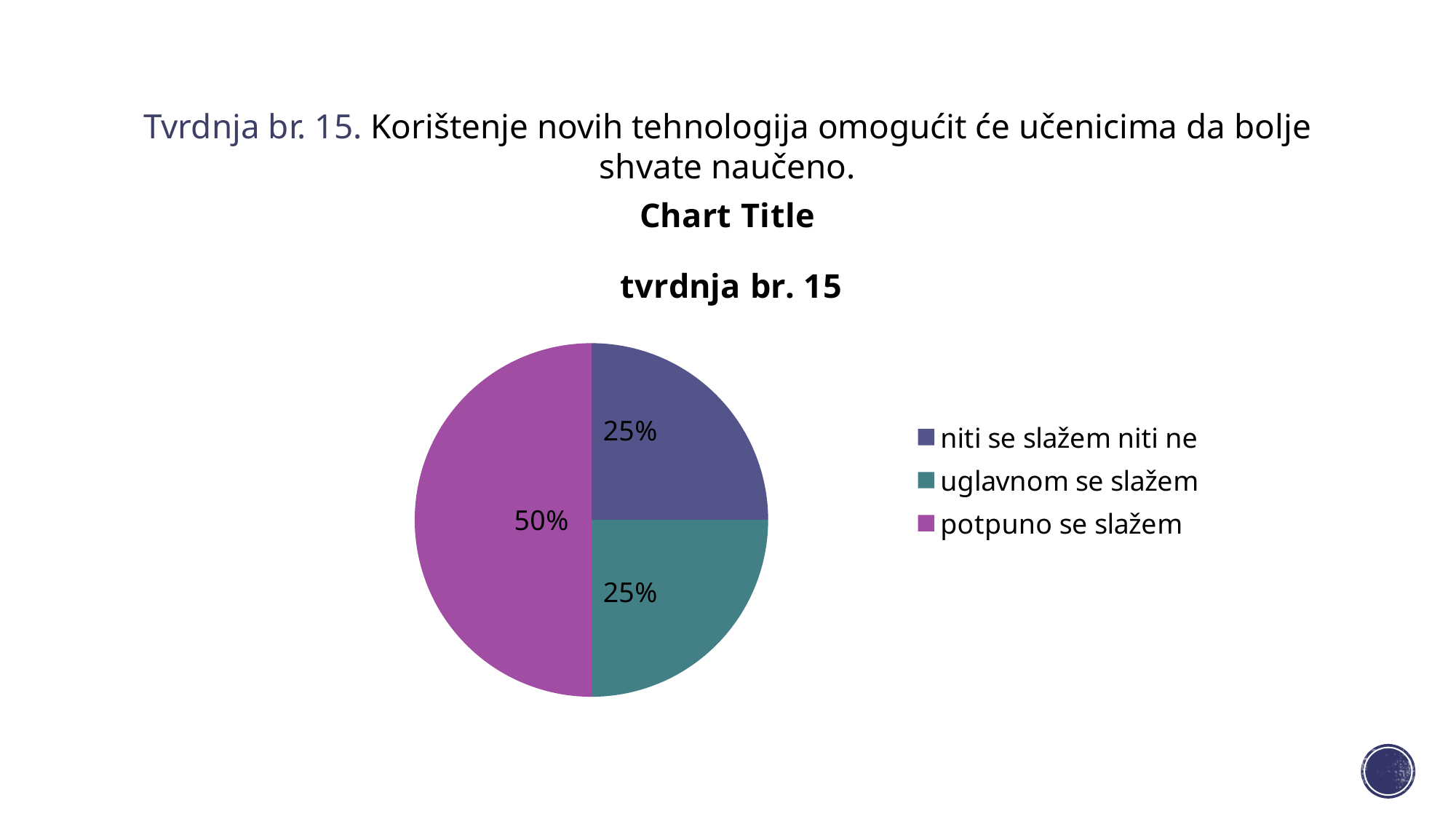
What is the difference between the share for "potpuno se slažem" and the share for "niti se slažem niti ne"? 25% How many slices does the pie chart have? 3 Which category has the largest slice of the pie? potpuno se slažem What is the title printed directly above the pie chart? tvrdnja br. 15 Which is larger, the slice for "potpuno se slažem" or the slice for "uglavnom se slažem"? potpuno se slažem What kind of chart is shown on the slide? pie chart What share of the pie does "potpuno se slažem" take? 50% What share of the pie does "uglavnom se slažem" take? 25% What colour is the slice for "potpuno se slažem"? purple What share of the pie does "niti se slažem niti ne" take? 25% How many entries does the legend list? 3